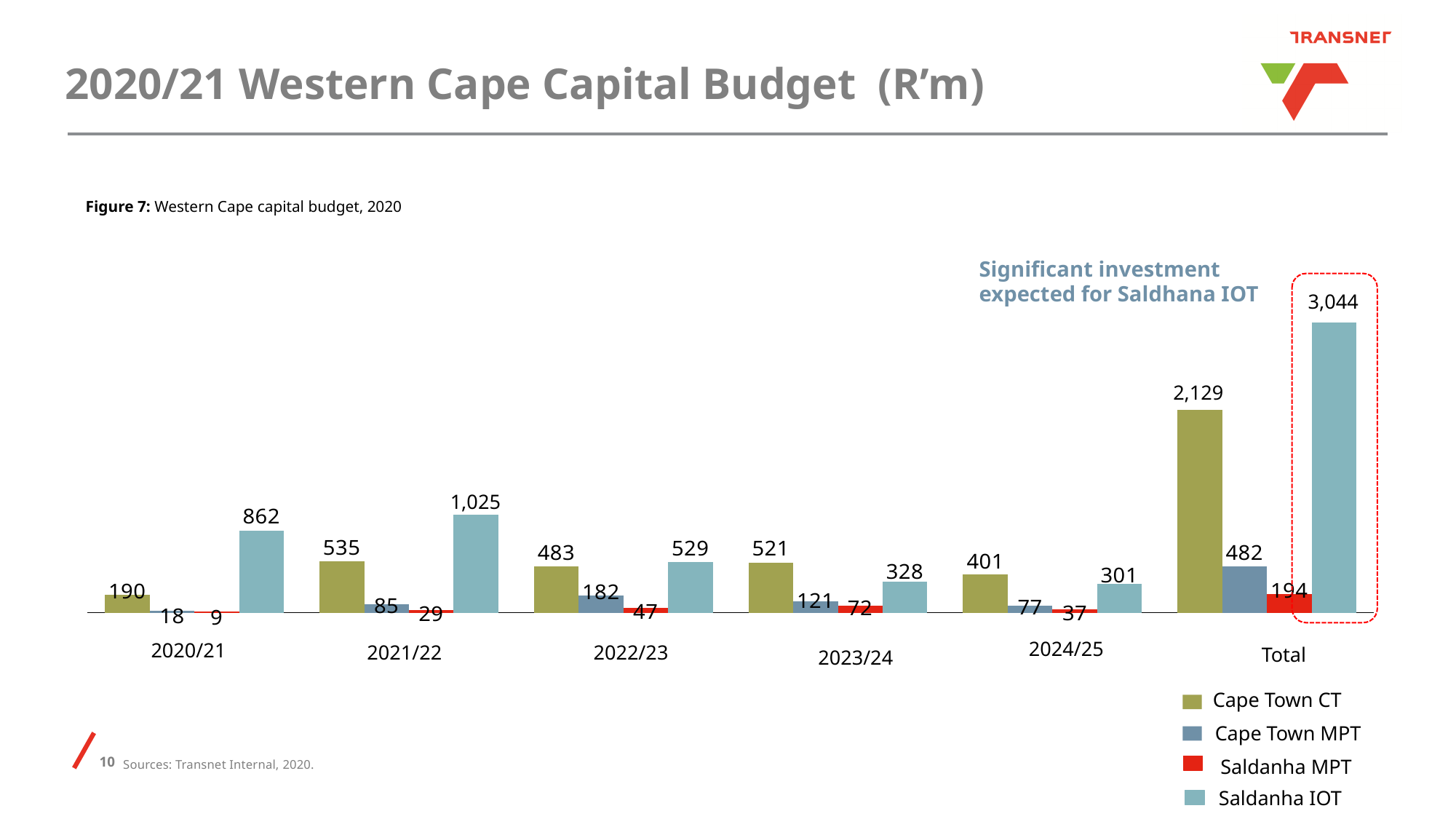
Do the Cape Town MPT values rise or fall from 2022/23 to 2024/25? Fall Which is larger in 2022/23: Cape Town CT or Saldanha IOT? Saldanha IOT What is the value for Saldanha MPT in 2020/21? 9 What kind of chart is shown on the slide? Bar chart Which series has the highest Total value? Saldanha IOT What is the value for Cape Town CT in 2023/24? 521 What is the value for Saldanha IOT in 2021/22? 1,025 How many series does the legend list? 4 How many categories are shown on the x axis? 6 What is the Total value for Cape Town MPT? 482 In which year is the Saldanha IOT value lowest? 2024/25 What is the difference between the Saldanha IOT and Cape Town CT values in 2020/21? 672